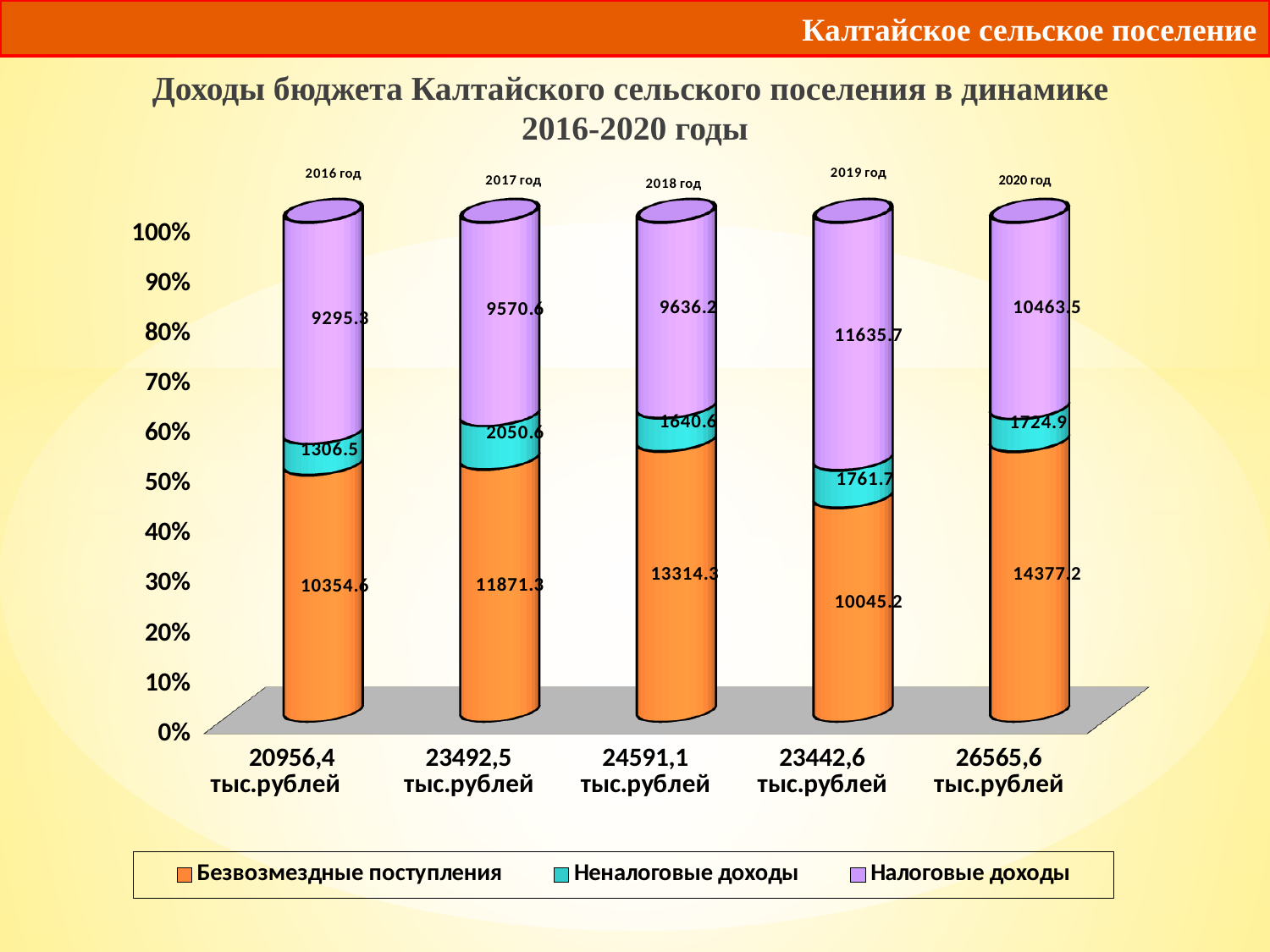
What is the value of Налоговые доходы for 2016 год? 9295.3 How many series does the legend list? 3 Which is larger: Безвозмездные поступления in 2018 год or in 2017 год? 2018 год What is the value of Безвозмездные поступления for 2020 год? 14377.2 What is the total budget income shown for 2018 год? 24591,1 тыс.рублей What kind of chart is shown on the slide? Stacked bar chart In which year is the value of Налоговые доходы the highest? 2019 год What is the difference between Налоговые доходы in 2019 год and in 2020 год? 1172.2 What is the difference between Безвозмездные поступления in 2020 год and in 2019 год? 4332.0 What is the value of Неналоговые доходы for 2019 год? 1761.7 In which year is the value of Неналоговые доходы the lowest? 2016 год How many years are shown on the chart? 5